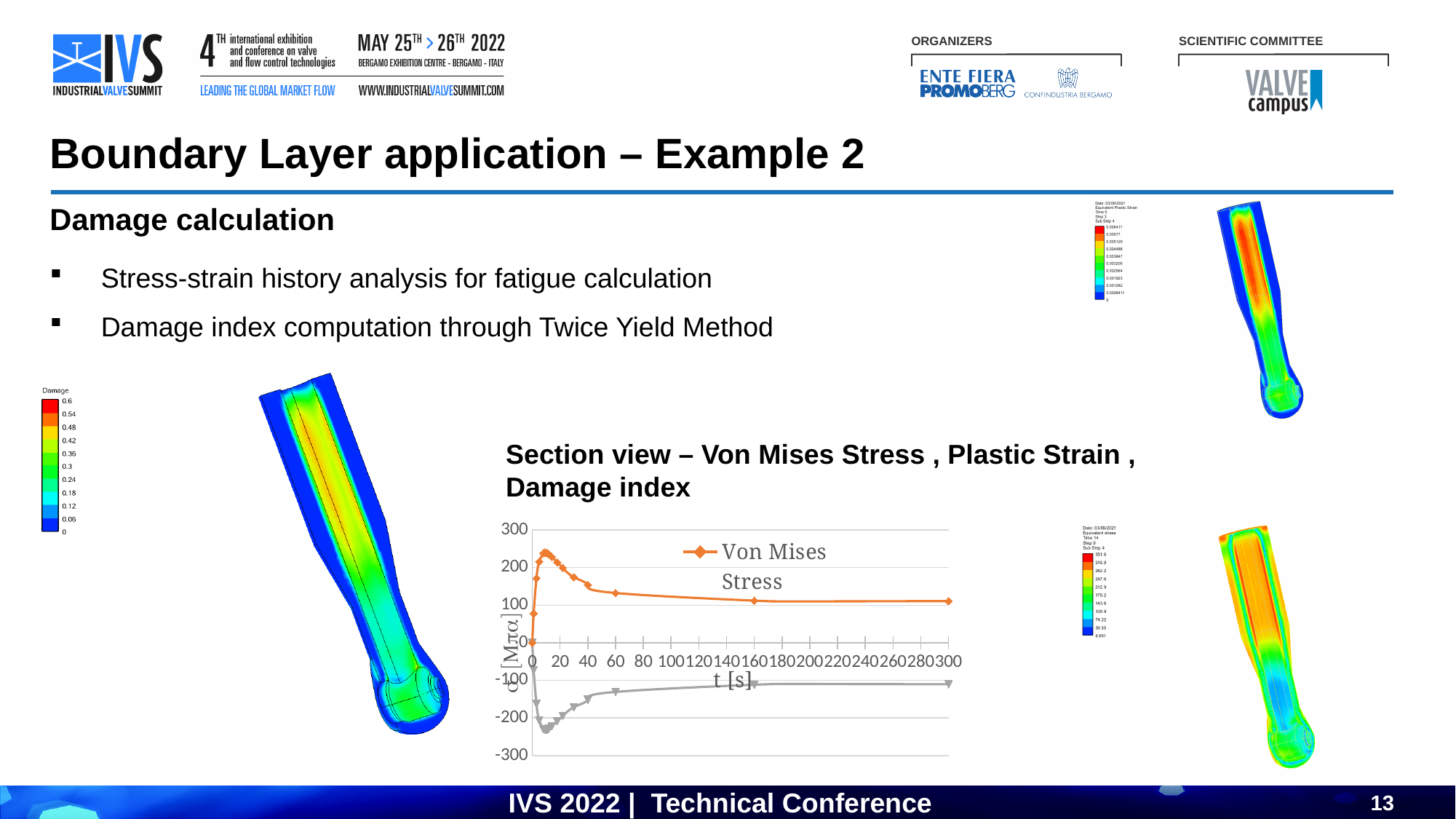
What is the label of the x axis of the stress-time chart? t [s] How many series does the legend of the stress-time chart list? 1 Is the value of the grey series at t = 300 greater or less than -200? greater What is the highest tick value shown on the y axis of the stress-time chart? 300 Does the Von Mises Stress series rise or fall between t = 60 and t = 300? fall Is the peak value of the Von Mises Stress series greater or less than 200? greater What kind of chart is shown at the bottom centre of the slide? line chart Is the lowest value of the grey series in the stress-time chart greater or less than -200? less What series name appears in the legend of the stress-time chart? Von Mises Stress Which series has the higher value at t = 300, the Von Mises Stress series or the grey series? Von Mises Stress